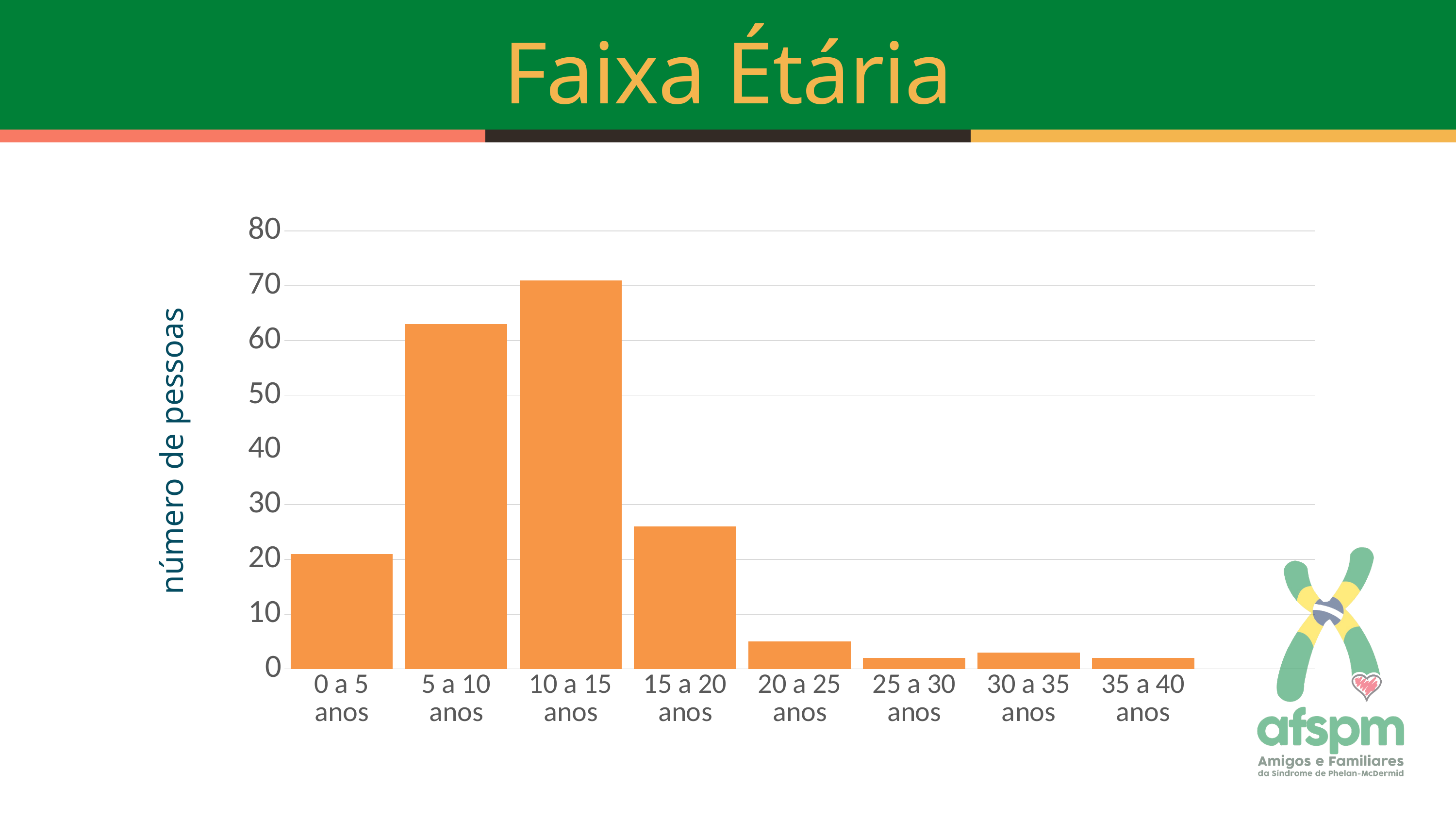
How many age categories are shown on the x axis? 8 Which is larger, the value for 5 a 10 anos or the value for 10 a 15 anos? 10 a 15 anos Is the value for 20 a 25 anos greater or less than 10? less What is the label on the vertical axis of the chart? número de pessoas Is the value for 15 a 20 anos greater or less than 30? less Is the value for 0 a 5 anos greater or less than 30? less What kind of chart is shown on the slide? bar chart Do the values rise or fall from 10 a 15 anos to 35 a 40 anos? fall Which age category has the highest number of people? 10 a 15 anos Which is larger, the value for 0 a 5 anos or the value for 15 a 20 anos? 15 a 20 anos